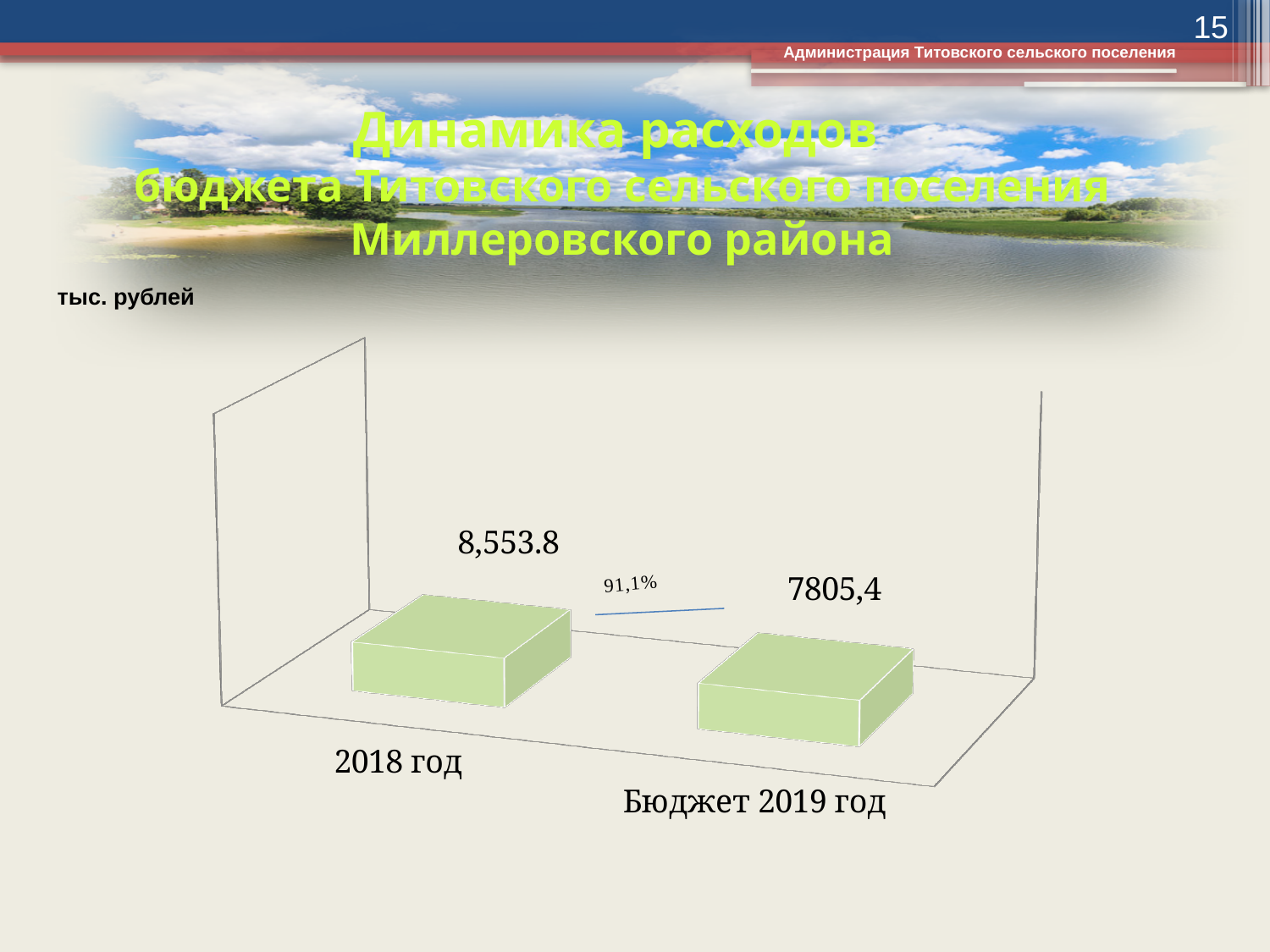
What is the difference between the value for 2018 год and the value for Бюджет 2019 год? 748.4 What is the value shown for Бюджет 2019 год? 7805,4 What is the value shown for 2018 год? 8,553.8 Which category has the lowest value? Бюджет 2019 год How many categories are plotted in the chart? 2 Which category has the highest value? 2018 год What kind of chart is shown on the slide? Bar chart In what units are the chart values given, according to the label above the chart? тыс. рублей What percentage is written between the two bars? 91,1% Do the values rise or fall from 2018 год to Бюджет 2019 год? Fall Which is larger, the value for 2018 год or the value for Бюджет 2019 год? 2018 год